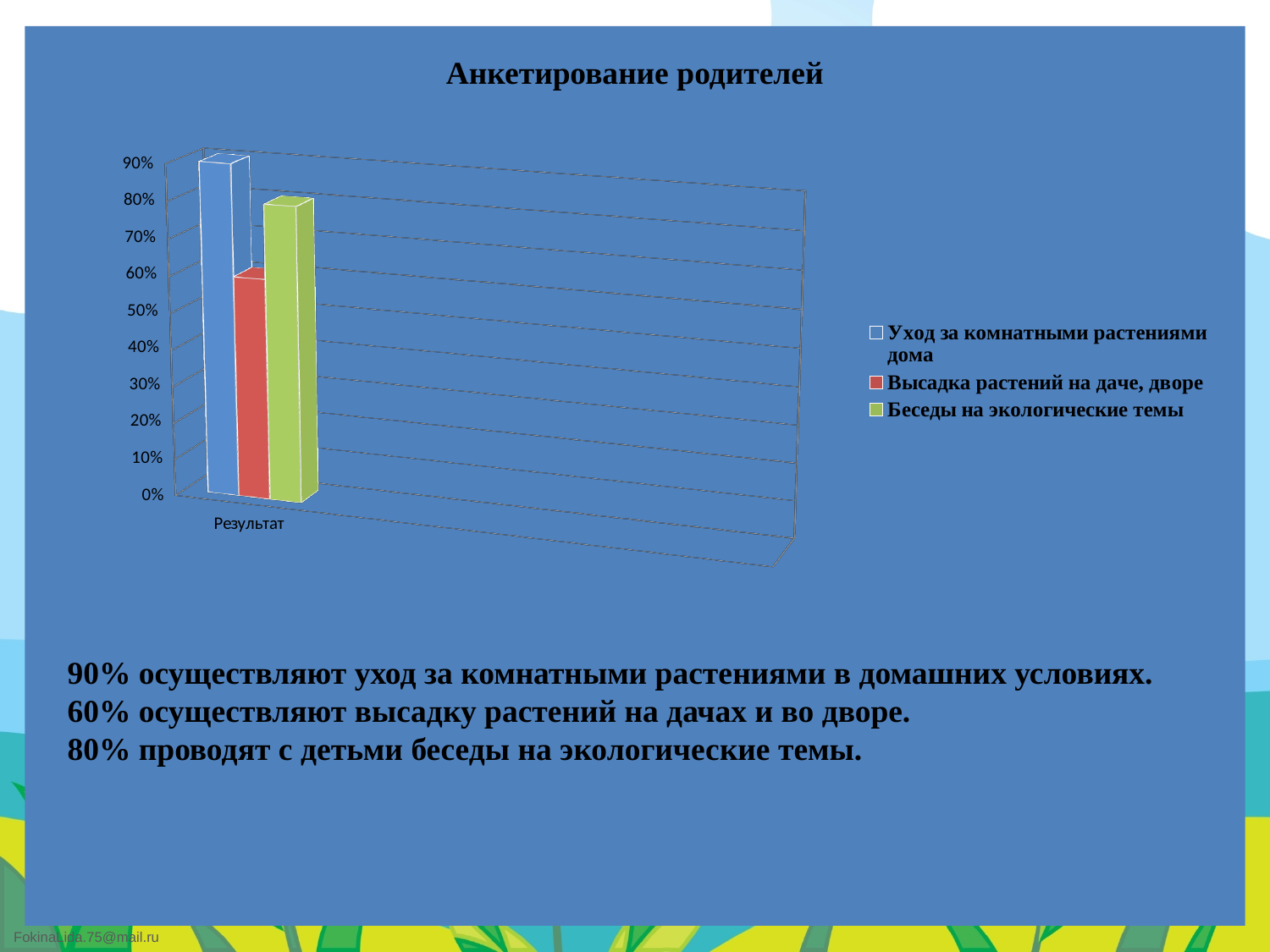
Which is larger: the value for 'Беседы на экологические темы' or the value for 'Высадка растений на даче, дворе'? Беседы на экологические темы How many categories are shown on the x axis? 1 Which series has the highest value? Уход за комнатными растениями дома What type of chart is shown on the slide? bar chart Which series has the lowest value? Высадка растений на даче, дворе What colour is the bar for 'Беседы на экологические темы'? green What is the title of the chart? Анкетирование родителей What is the difference between the values for 'Уход за комнатными растениями дома' and 'Высадка растений на даче, дворе'? 30% What is the value for 'Беседы на экологические темы'? 80% What is the value for 'Высадка растений на даче, дворе'? 60% What is the value for 'Уход за комнатными растениями дома'? 90% How many series does the legend list? 3